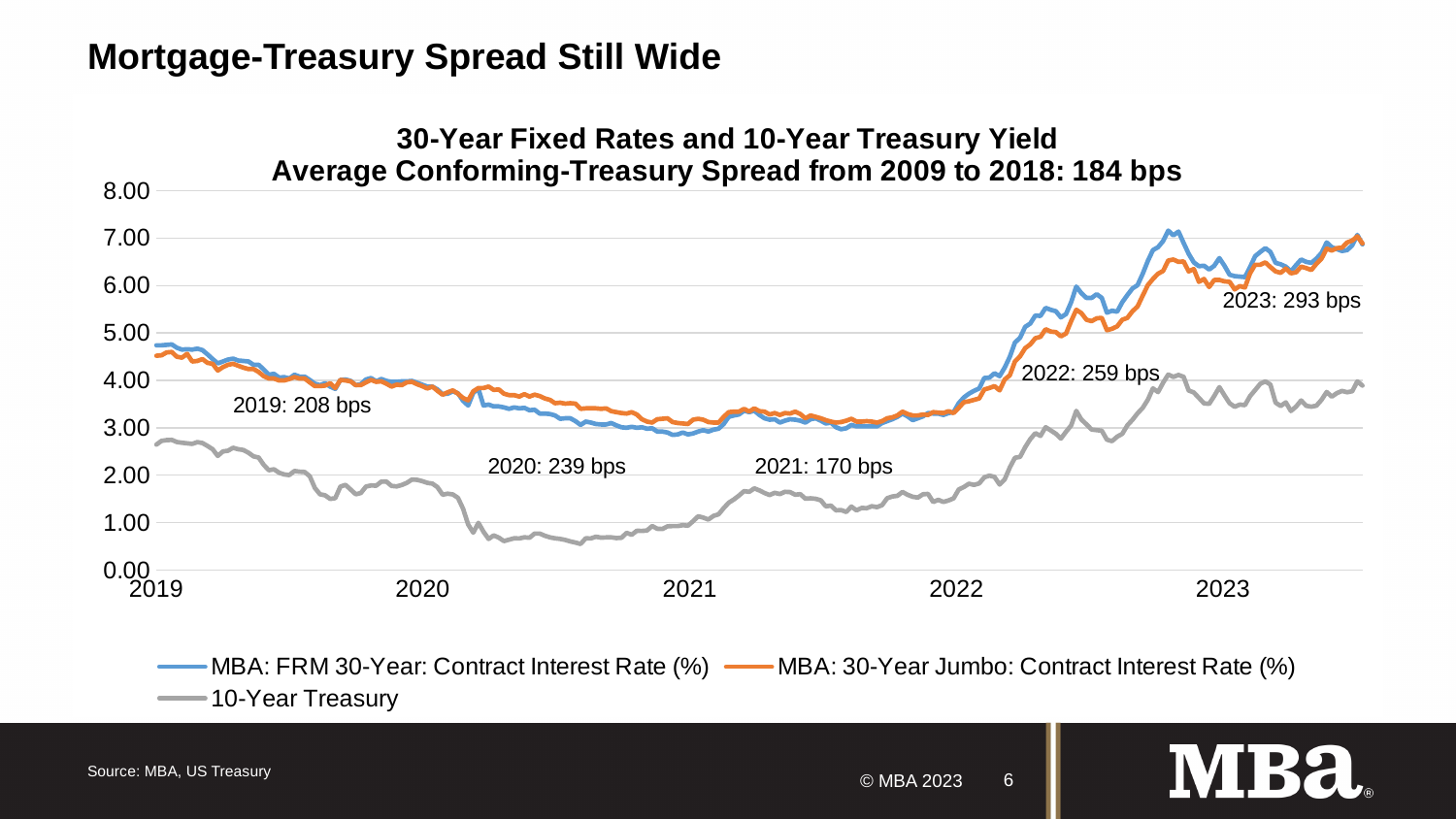
Which year has the lowest annotated spread? 2021 What is the annotated spread for 2019? 208 bps Is the 10-Year Treasury value in mid-2020 greater or less than 1.00? less Which year has the highest annotated spread? 2023 What is the annotated spread for 2021? 170 bps What is the annotated spread for 2023? 293 bps What kind of chart is shown on the slide? line chart What is the difference between the annotated spreads for 2023 and 2022? 34 bps How many series does the legend list? 3 What average Conforming-Treasury spread from 2009 to 2018 is stated in the chart title? 184 bps Does the 10-Year Treasury line rise or fall from the start of 2022 to the start of 2023? rise Is the MBA: FRM 30-Year: Contract Interest Rate (%) value at the end of 2023 greater or less than 6.00? greater